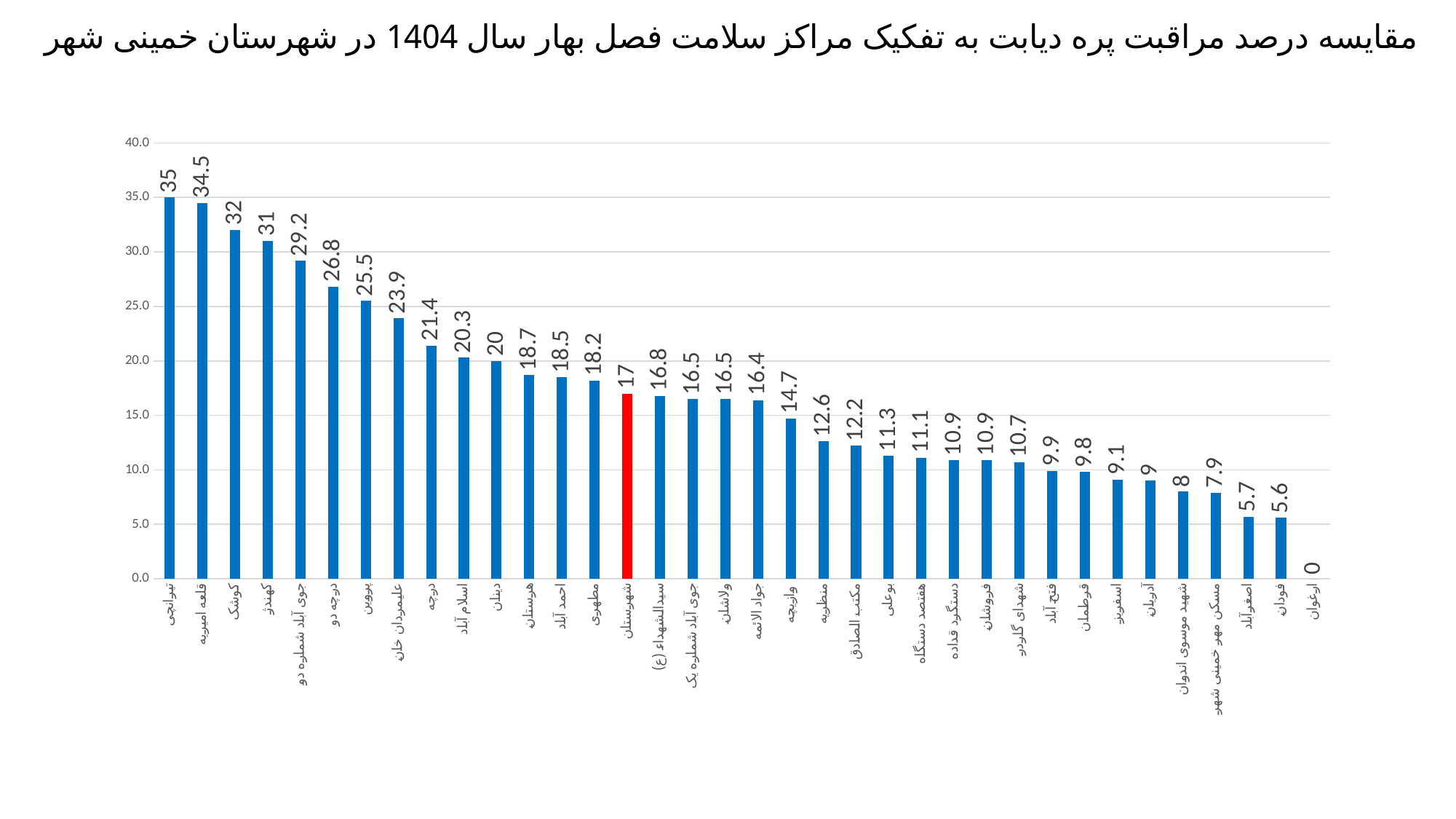
What is the difference between the values for کوشک and کهندژ? 1 Which is larger, the value for پروین or the value for درچه? پروین What is the value for وازیچه? 14.7 Which category has the lowest value? ارغوان What is the difference between the values for تیرانچی and شهرستان? 18 What type of chart is shown on the slide? bar chart How many bars are plotted in the chart? 36 Which category has the highest value? تیرانچی What is the value for شهرستان (the red bar)? 17 Do the values generally rise or fall from left to right along the x axis? fall Which bar is highlighted in red rather than blue? شهرستان What is the value for تیرانچی? 35